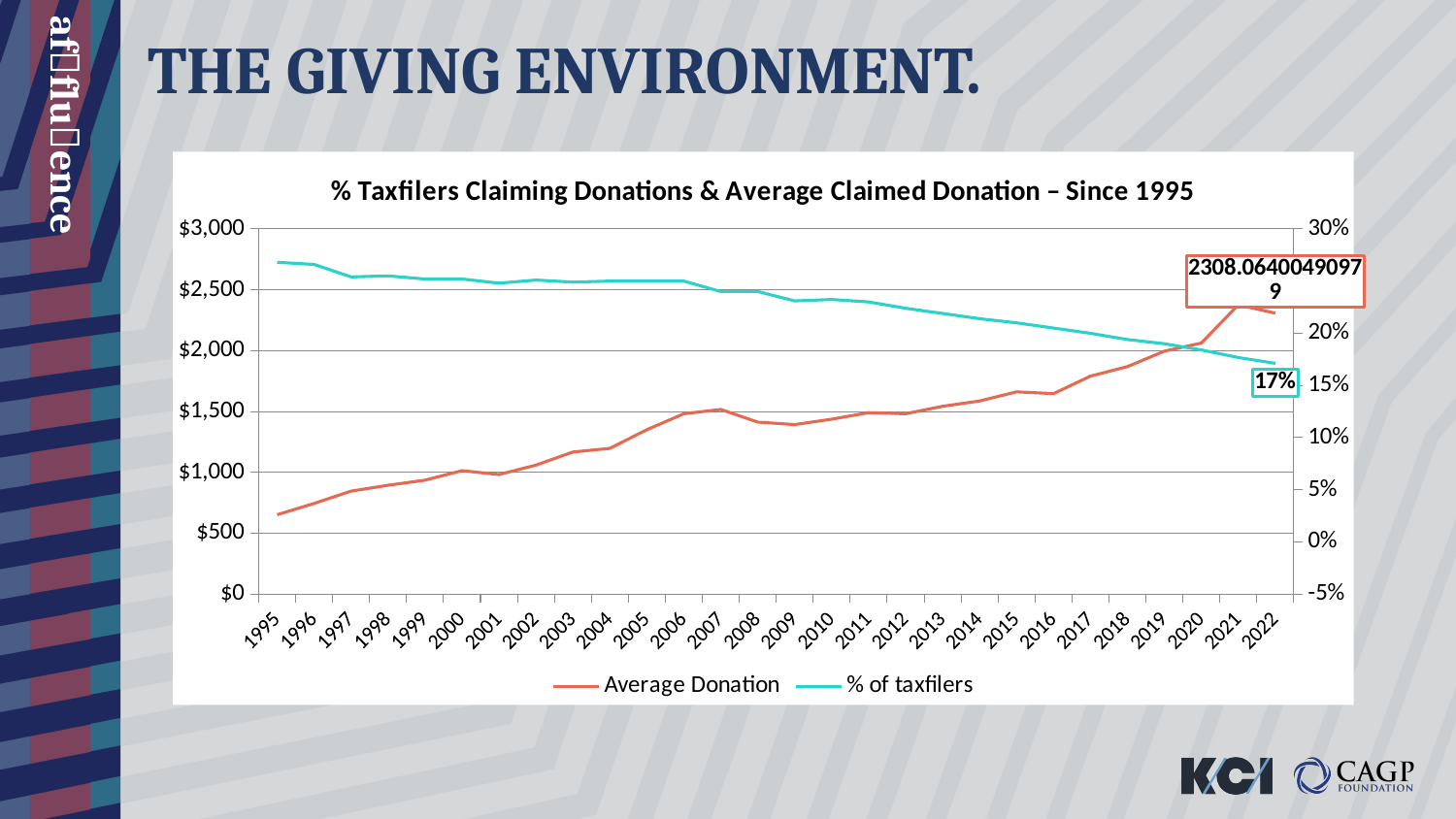
Is the % of taxfilers for 1995 greater or less than 25%? greater Does the % of taxfilers line generally rise or fall from 1995 to 2022? fall What is the Average Donation value labelled for 2022? 2308.06400490979 Does the Average Donation line generally rise or fall from 1995 to 2022? rise What is the % of taxfilers value labelled for 2022? 17% Which year has the larger Average Donation, 2000 or 2005? 2005 In which year is the Average Donation lowest? 1995 What type of chart is shown on the slide? line chart In which year is the % of taxfilers highest? 1995 How many years are shown along the x axis? 28 How many series does the legend list? 2 Is the Average Donation for 1995 greater or less than $1,000? less